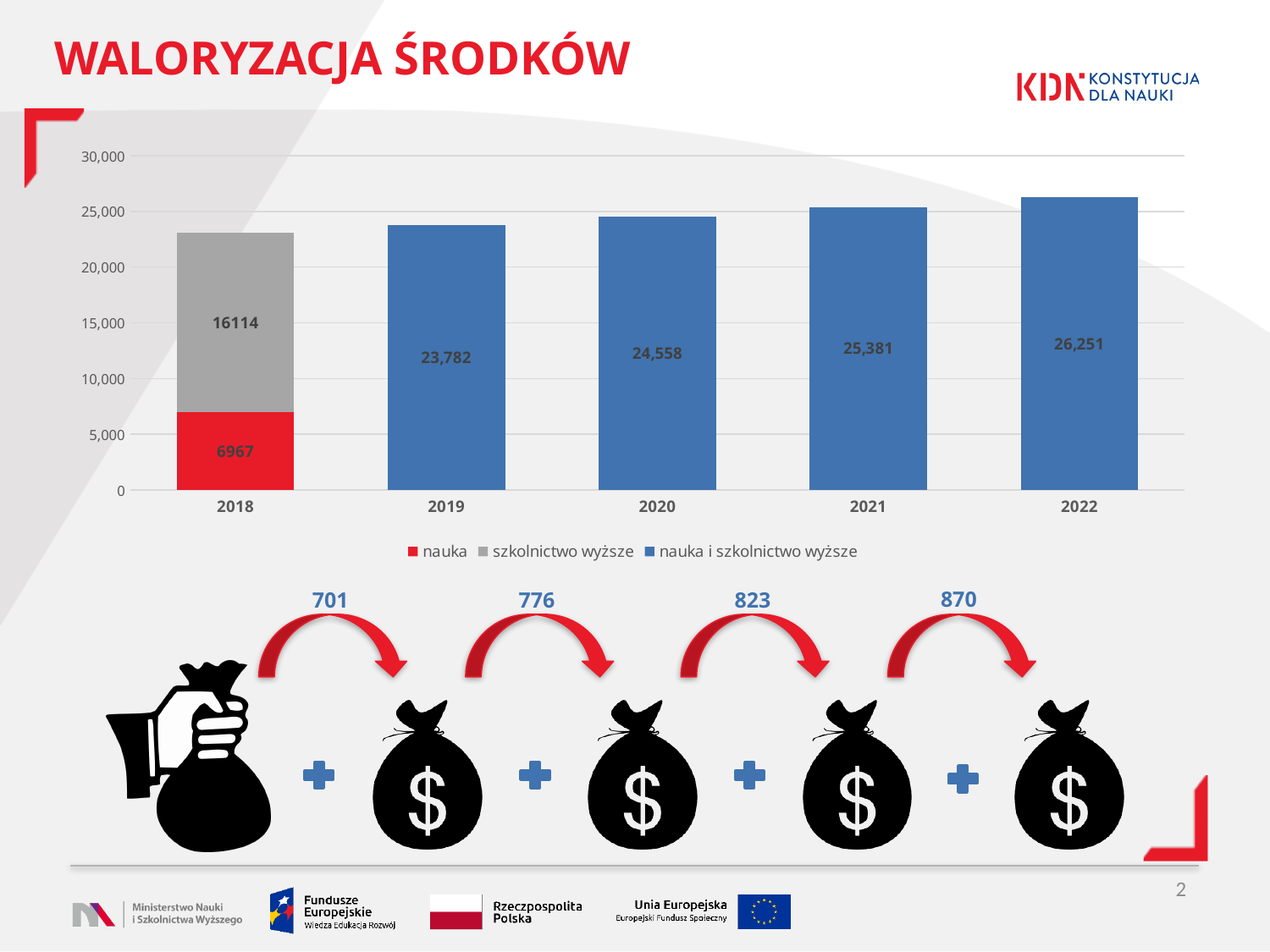
How many series does the legend list? 3 What is the difference between the values for 2021 and 2020? 823 What is the value for 'nauka i szkolnictwo wyższe' in 2022? 26,251 How many years are shown on the x axis? 5 What is the value for 2020? 24,558 Do the bar values rise or fall from 2019 to 2022? rise Which is larger, the value for 2019 or the value for 2021? 2021 What is the value of the 'szkolnictwo wyższe' segment in 2018? 16114 What is the difference between the values for 2022 and 2019? 2,469 Which year has the highest bar? 2022 What is the total of the stacked bar for 2018? 23081 What is the value of the 'nauka' segment in 2018? 6967